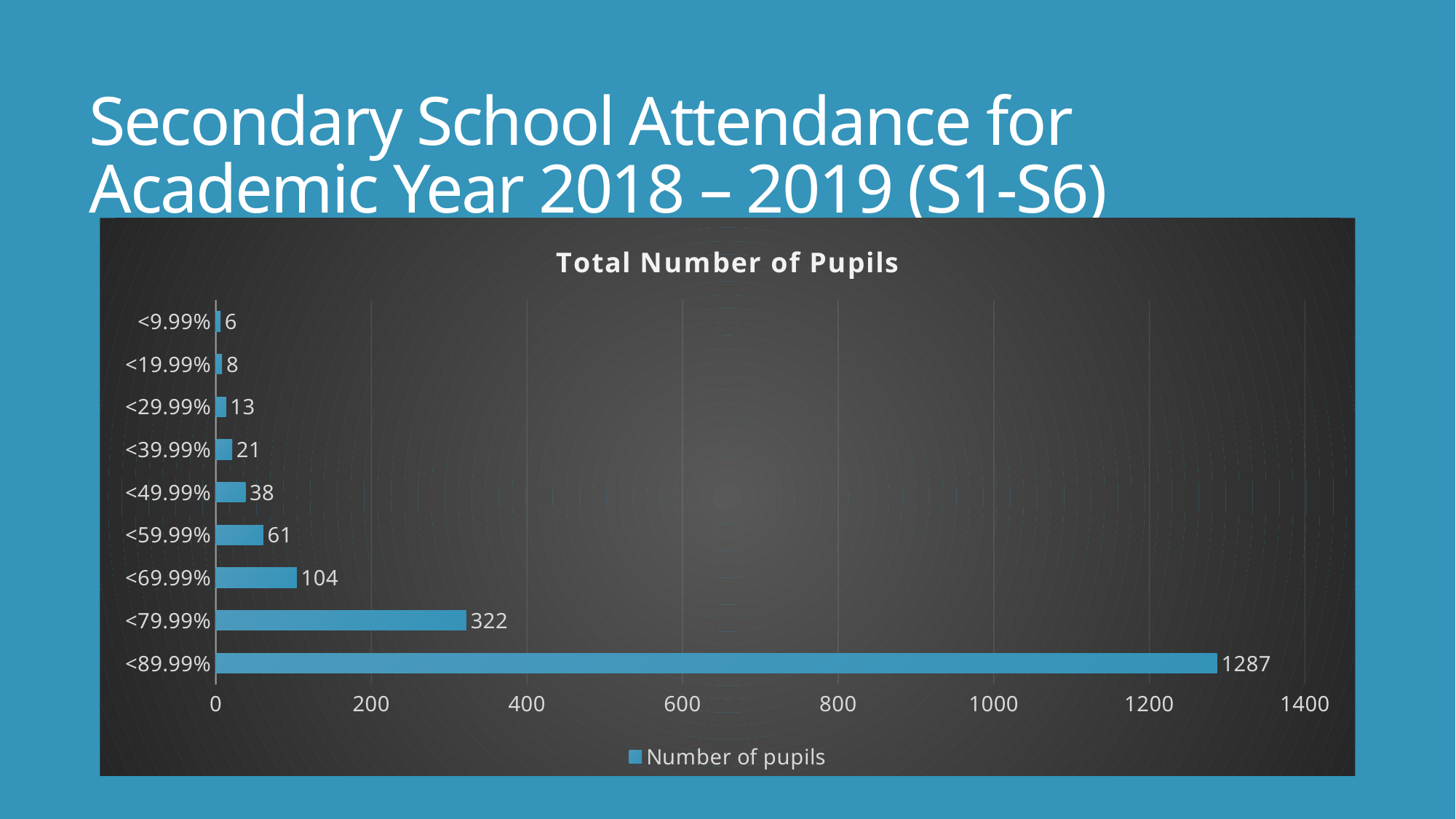
Is the value for <79.99% greater or less than 400? less What type of chart is shown on the slide? Bar chart Which category has the highest number of pupils? <89.99% What is the number of pupils in the <89.99% category? 1287 Which category has more pupils, <29.99% or <19.99%? <29.99% What is the difference in number of pupils between the <59.99% and <49.99% categories? 23 What is the difference in number of pupils between the <89.99% and <79.99% categories? 965 How many categories are shown on the chart? 9 What is the title of the chart? Total Number of Pupils Which category has the lowest number of pupils? <9.99% What is the number of pupils in the <39.99% category? 21 What is the number of pupils in the <69.99% category? 104